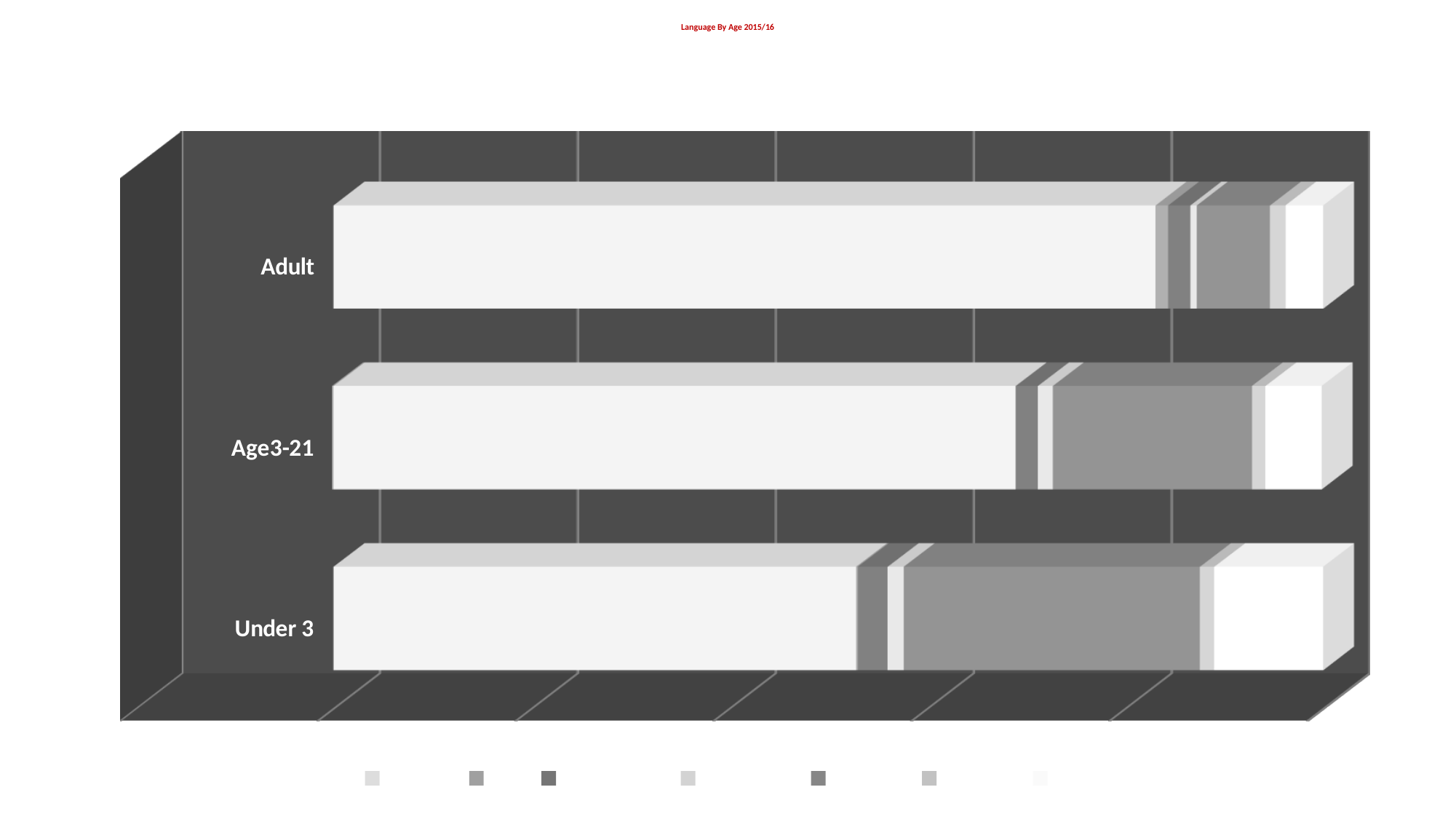
Which category is listed at the top of the chart? Adult Which category has the shortest leftmost (lightest) bar segment? Under 3 Is the leftmost bar segment longer for Adult or for Under 3? Adult How many series entries does the legend show? 7 Which age categories are listed on the chart's vertical axis? Adult, Age3-21, Under 3 Is the leftmost bar segment longer for Age3-21 or for Under 3? Age3-21 What is the title of the chart? Language By Age 2015/16 Which category has the longest leftmost (lightest) bar segment? Adult What type of chart is shown on the slide? Bar chart How many age categories are shown on the chart? 3